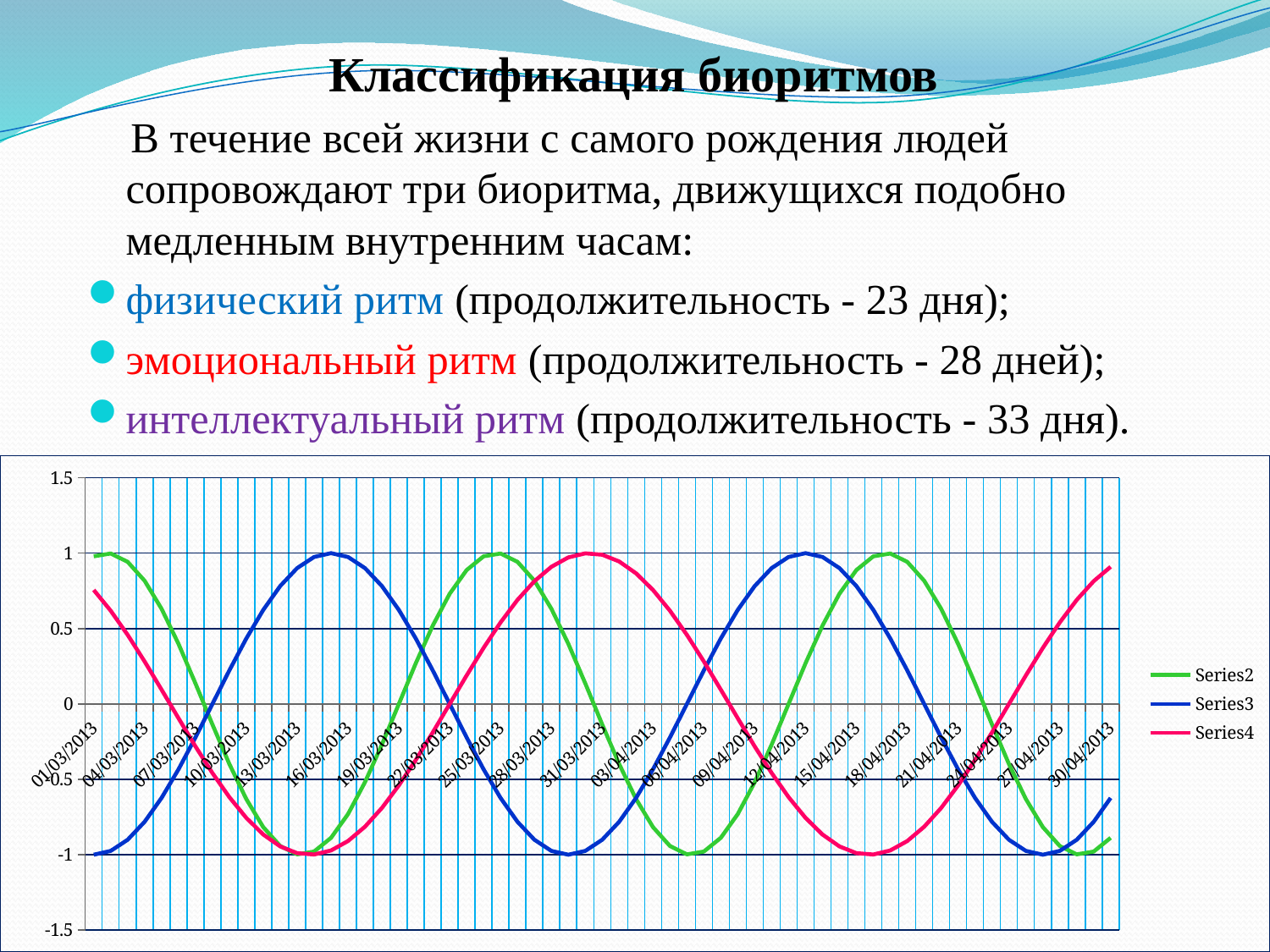
Is the value of Series2 at 01/03/2013 greater or less than 0.5? greater Is the value of Series4 at 13/03/2013 greater or less than -0.5? less What are the series names listed in the chart legend? Series2, Series3, Series4 Is the value of Series3 at 16/03/2013 greater or less than 0.5? greater What colour is the Series2 line in the chart? green At 16/03/2013, which is larger: Series3 or Series2? Series3 How many date labels are shown along the x axis of the chart? 21 At 01/03/2013, which is larger: Series2 or Series3? Series2 What kind of chart is shown on the slide? line chart How many series does the chart legend list? 3